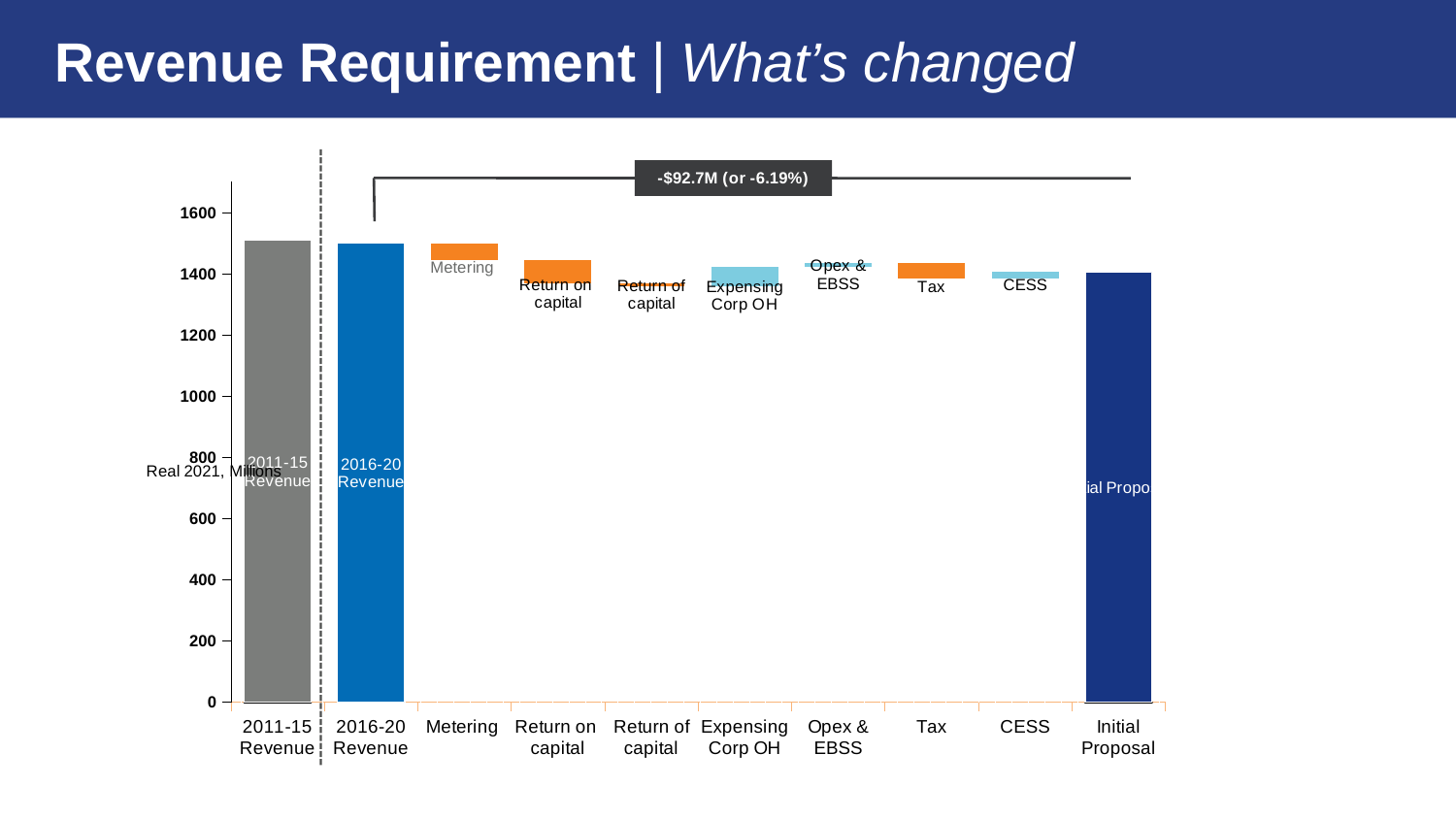
Does the revenue requirement rise or fall from 2016-20 Revenue to Initial Proposal? fall What kind of chart is shown on the slide? bar chart Is the value for Initial Proposal greater or less than 1200? greater Which is larger, the value for 2011-15 Revenue or the value for Initial Proposal? 2011-15 Revenue What change in revenue requirement does the annotation above the chart state? -$92.7M (or -6.19%) Is the value for 2011-15 Revenue greater or less than 1400? greater Which is larger, the value for 2016-20 Revenue or the value for Initial Proposal? 2016-20 Revenue How many categories are shown along the x axis of the chart? 10 Is the value for Initial Proposal greater or less than 1600? less What is the highest value shown on the vertical axis of the chart? 1600 What is the label on the vertical axis of the chart? Real 2021, Millions